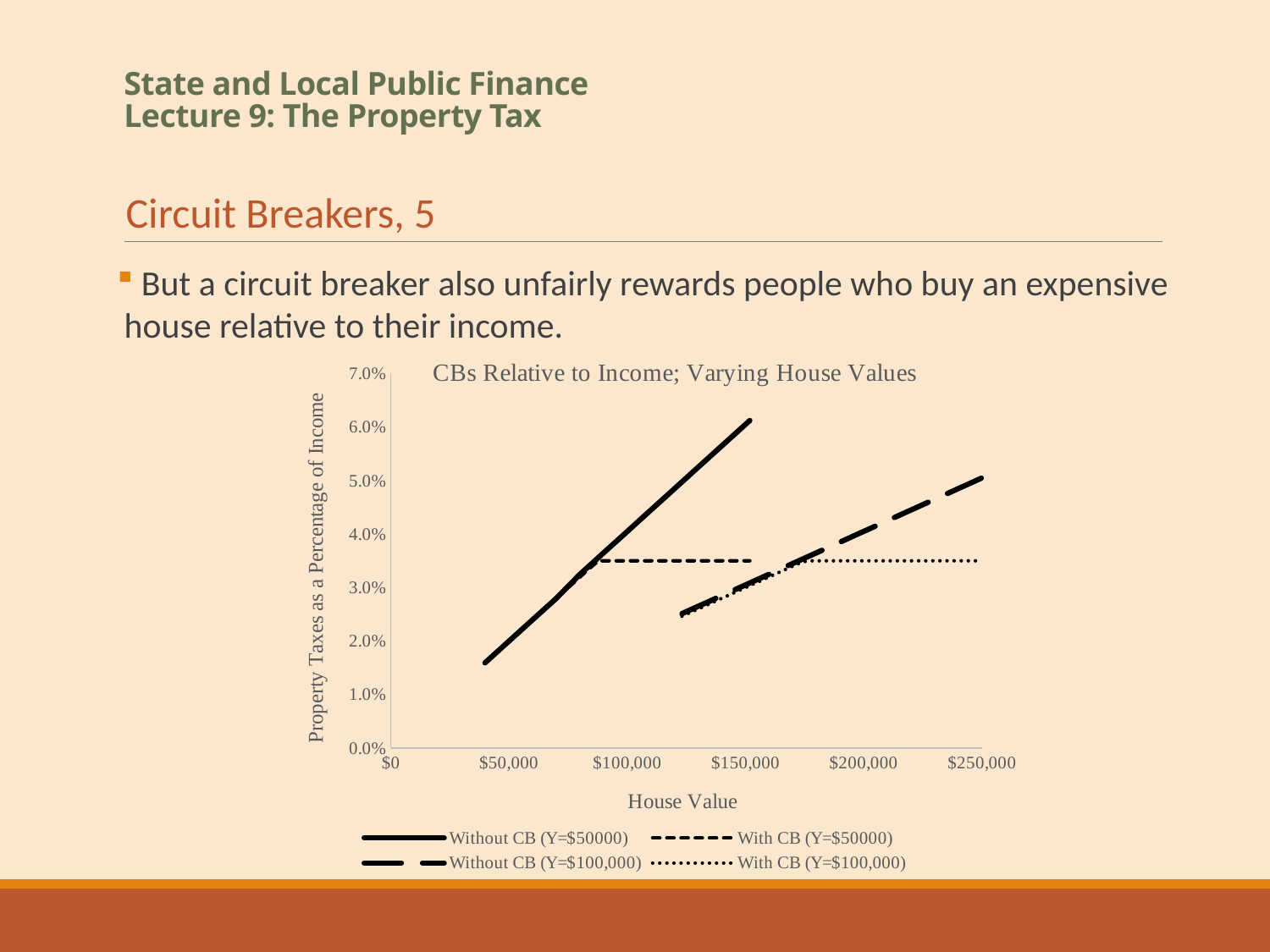
Which series reaches the highest value on the chart? Without CB (Y=$50000) Does the Without CB (Y=$100,000) line rise or fall as house value increases? rises Is the value of the With CB (Y=$100,000) line at a house value of $250,000 greater or less than 4.0%? less How many series does the chart's legend list? 4 What is the label of the chart's vertical axis? Property Taxes as a Percentage of Income Is the value of the Without CB (Y=$50000) line at a house value of $150,000 greater or less than 5.0%? greater At a house value of $250,000, which is larger: the Without CB (Y=$100,000) line or the With CB (Y=$100,000) line? Without CB (Y=$100,000) What is the title of the chart? CBs Relative to Income; Varying House Values At a house value of $150,000, which is larger: the Without CB (Y=$50000) line or the With CB (Y=$50000) line? Without CB (Y=$50000) What kind of chart is shown on the slide? line chart Is the value of the With CB (Y=$50000) line at a house value of $150,000 greater or less than 4.0%? less